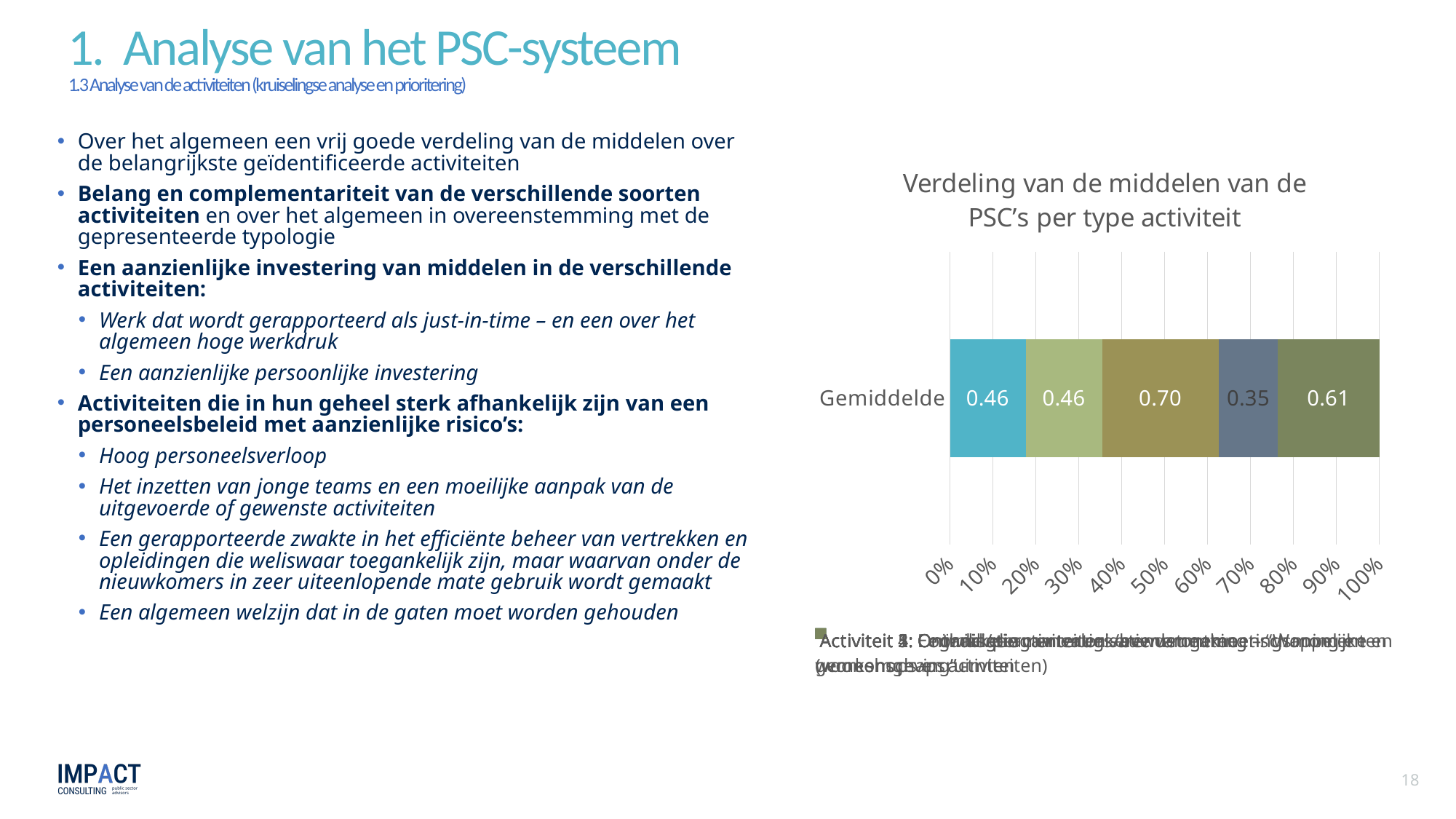
Which is larger: the value of the olive/gold segment or the value of the dark green segment? The olive/gold segment (0.70) What value is printed on the third (olive/gold) segment of the Gemiddelde bar? 0.70 What value is printed on the fourth (grey-blue) segment of the Gemiddelde bar? 0.35 What value is printed on the last (dark green) segment of the Gemiddelde bar? 0.61 What is the title of the chart? Verdeling van de middelen van de PSC’s per type activiteit What value is printed on the first (teal) segment of the Gemiddelde bar? 0.46 Which segment of the Gemiddelde bar has the highest printed value? The third (olive/gold) segment, 0.70 What kind of chart is shown on the slide? Stacked bar chart Which segment of the Gemiddelde bar has the lowest printed value? The fourth (grey-blue) segment, 0.35 What is the difference between the highest segment value (0.70) and the lowest segment value (0.35) in the Gemiddelde bar? 0.35 What is the label of the single category shown on the chart's vertical axis? Gemiddelde How many segments make up the stacked bar for Gemiddelde? 5